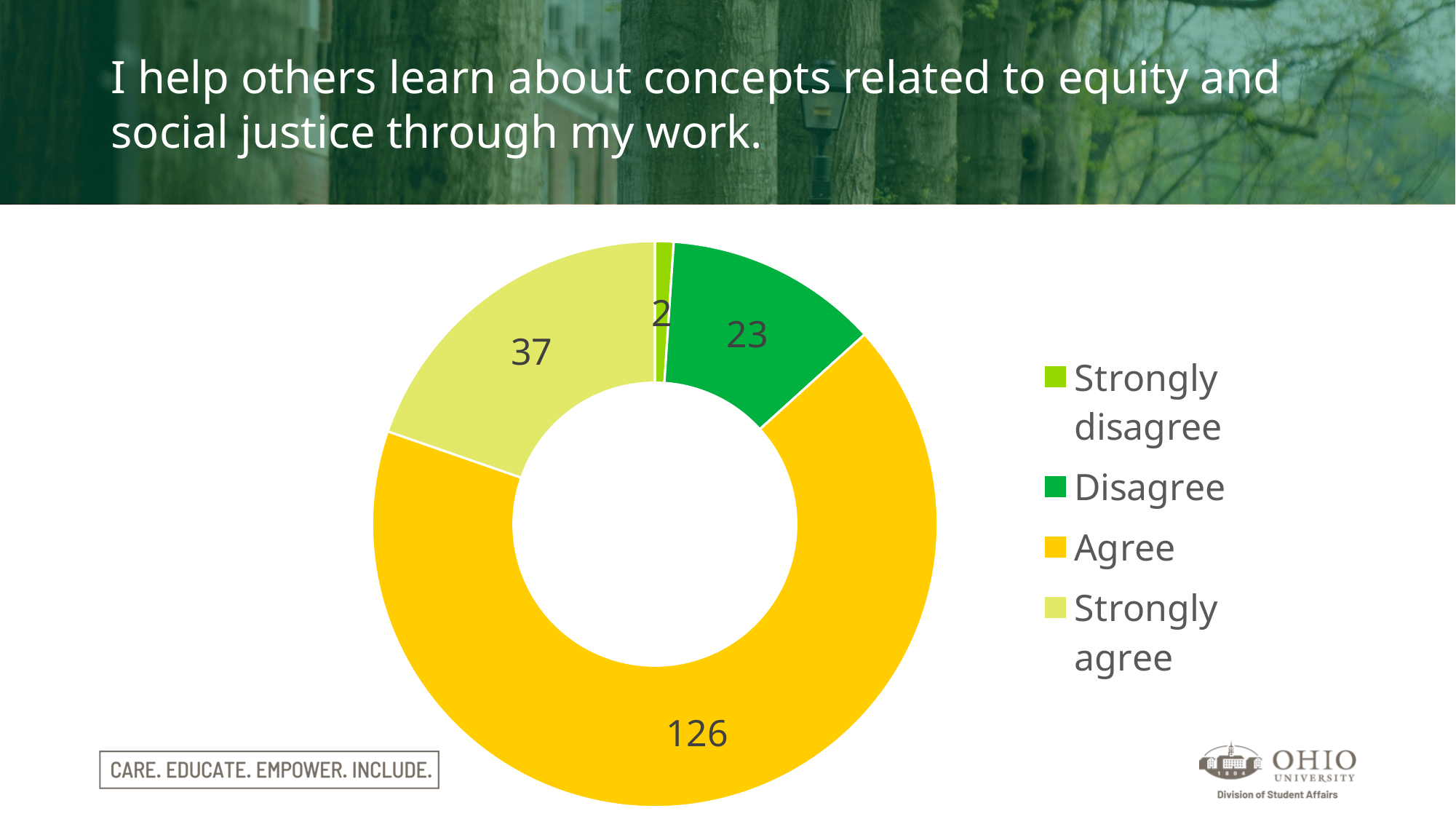
How many response categories does the chart show? 4 How many respondents selected Strongly agree? 37 Which colour represents Agree in the chart? Yellow How many respondents selected Agree? 126 Which is larger, the Disagree count or the Strongly agree count? Strongly agree What is the total number of responses across all four categories? 188 Which response category has the smallest value? Strongly disagree Which response category has the largest value? Agree What is the difference between the Agree and Strongly agree counts? 89 How many respondents selected Strongly disagree? 2 How many respondents selected Disagree? 23 What kind of chart is shown on the slide? Doughnut chart